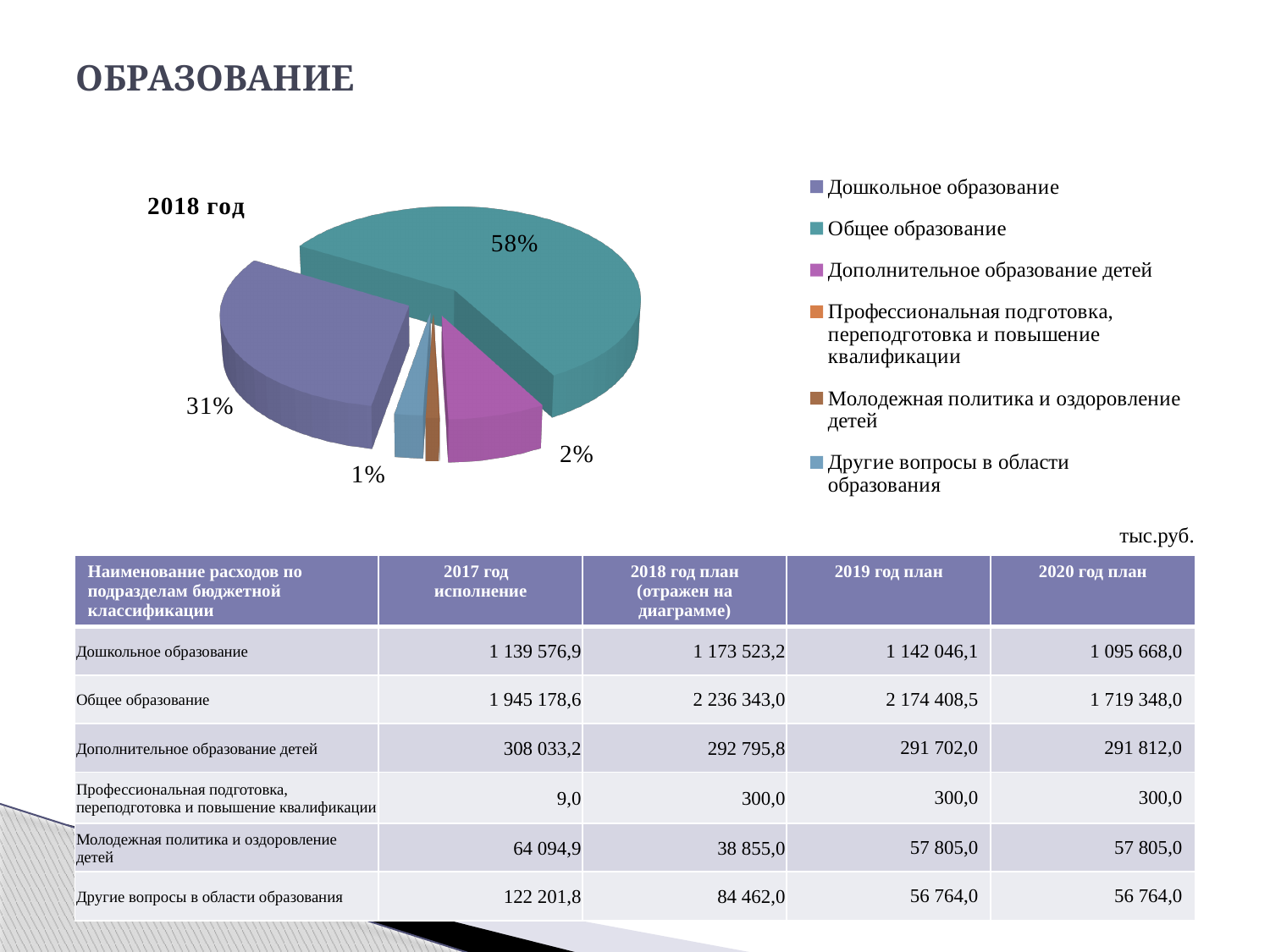
Which is larger in the pie chart: Дошкольное образование or Дополнительное образование детей? Дошкольное образование What share of the pie does Дошкольное образование have? 31% How many entries does the legend of the pie chart list? 6 Which is larger in the pie chart: Общее образование or Дошкольное образование? Общее образование Is the share for Общее образование greater or less than 50%? greater What share of the pie does Общее образование have? 58% Which colour represents Общее образование in the pie chart? teal What is the title of the pie chart? 2018 год Which category has the largest slice of the pie? Общее образование What kind of chart is shown on the slide? pie chart What is the difference in percentage points between the Общее образование slice and the Дошкольное образование slice? 27